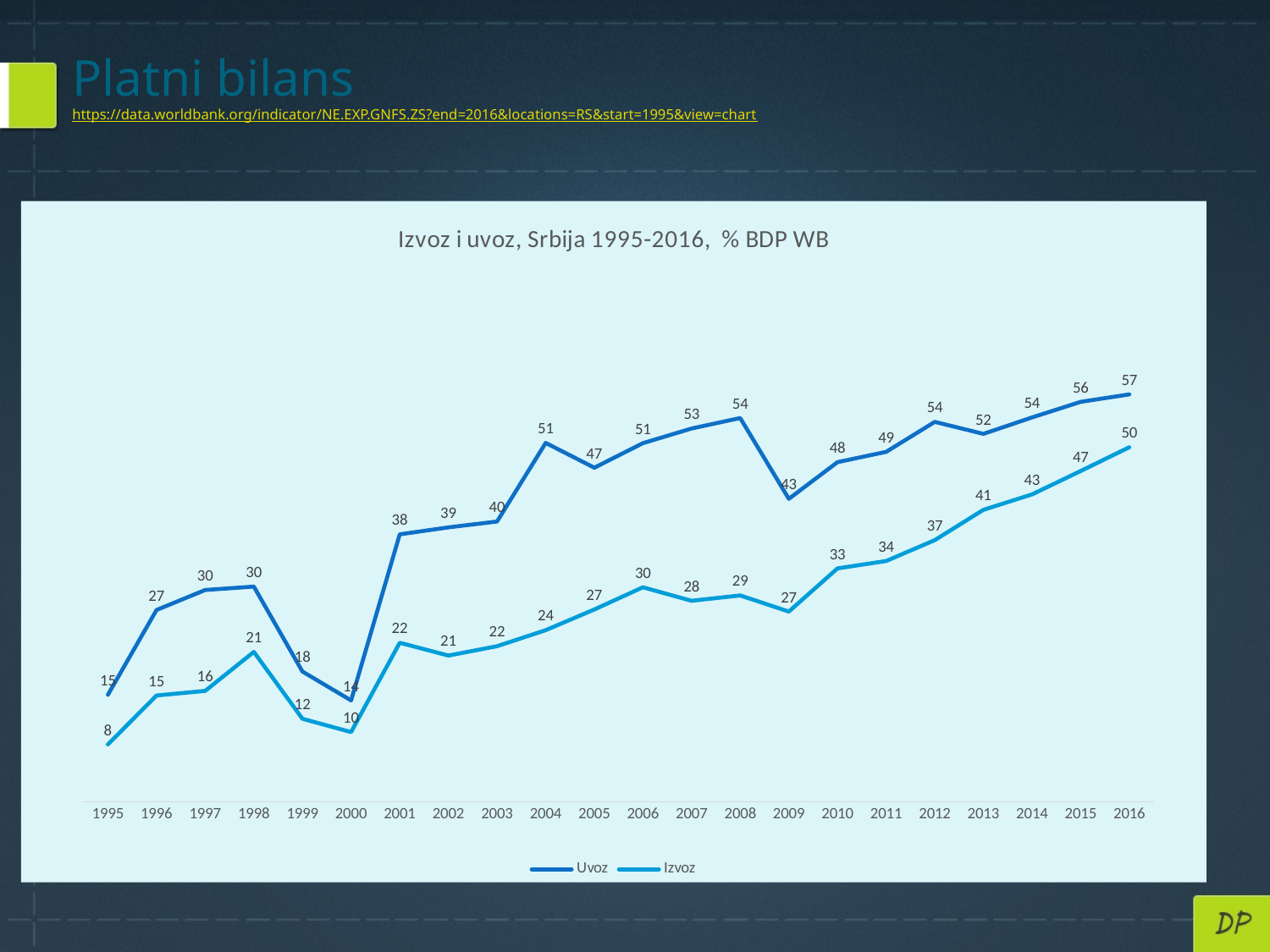
How many series does the legend list? 2 What is the title of the chart? Izvoz i uvoz, Srbija 1995-2016, % BDP WB What is the value of Izvoz in 1995? 8 In which year is Uvoz at its highest? 2016 Which is larger in 2004, Uvoz or Izvoz? Uvoz What is the value of Izvoz in 2009? 27 Does Izvoz rise or fall from 2010 to 2016? Rise What is the difference between Uvoz and Izvoz in 2008? 25 What type of chart is shown on the slide? Line chart How many years are plotted along the x axis? 22 In which year is Izvoz at its lowest? 1995 What is the value of Uvoz in 2016? 57